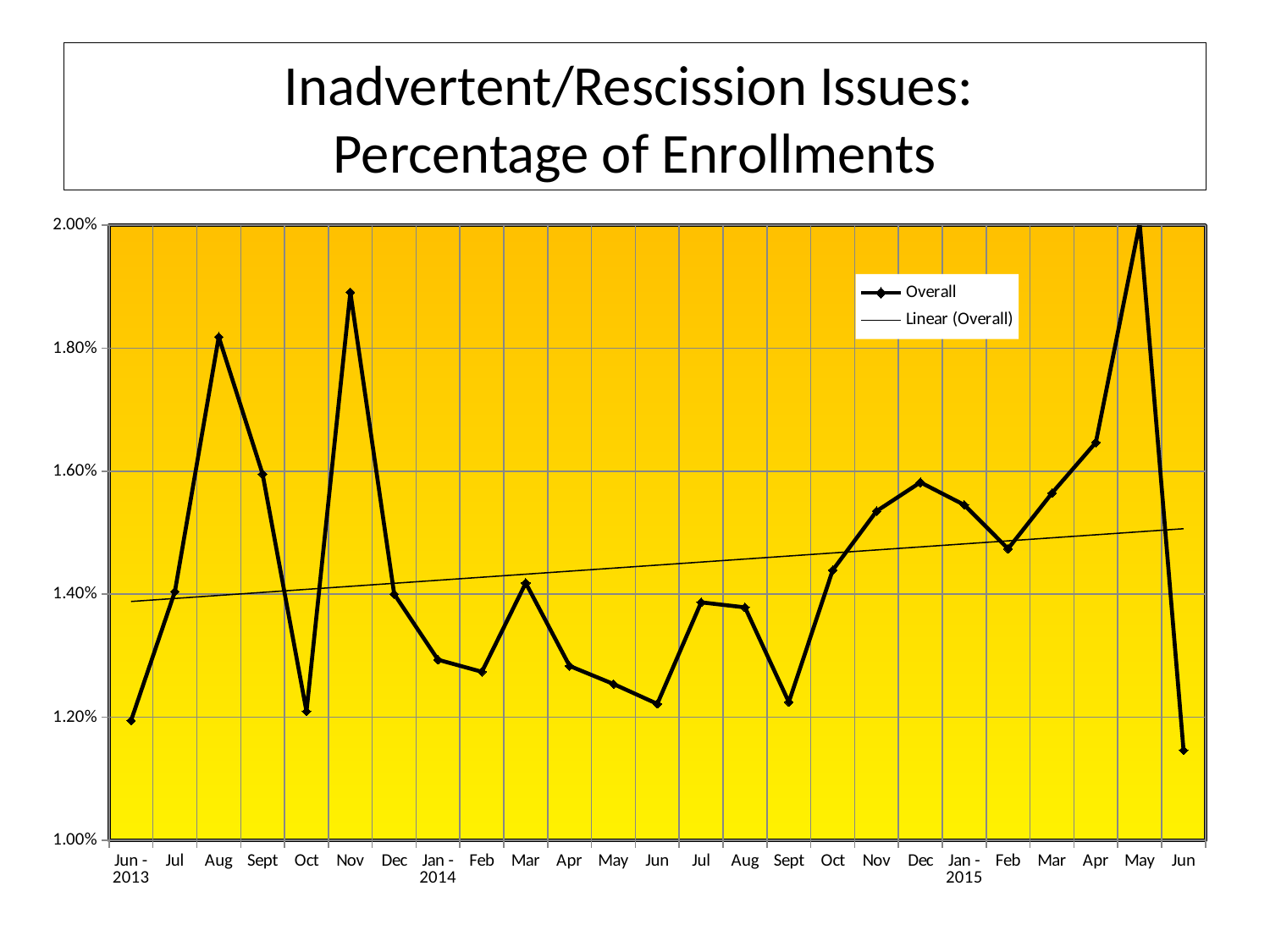
Is the Overall value for Dec 2014 greater or less than 1.40%? greater Does the Linear (Overall) trendline rise or fall from Jun 2013 to Jun 2015? Rises How many entries does the legend list? 2 What kind of chart is shown on the slide? Line chart What is the title of the chart? Inadvertent/Rescission Issues: Percentage of Enrollments Is the Overall value for Oct 2013 greater or less than 1.40%? less In which month is the Overall percentage highest? May 2015 Is the Overall value for Nov 2013 greater or less than 1.80%? greater What are the two entries listed in the legend? Overall and Linear (Overall) In which month is the Overall percentage lowest? Jun 2015 Which month has a higher Overall value, Dec 2014 or Feb 2015? Dec 2014 How many monthly data points are plotted on the Overall line? 25